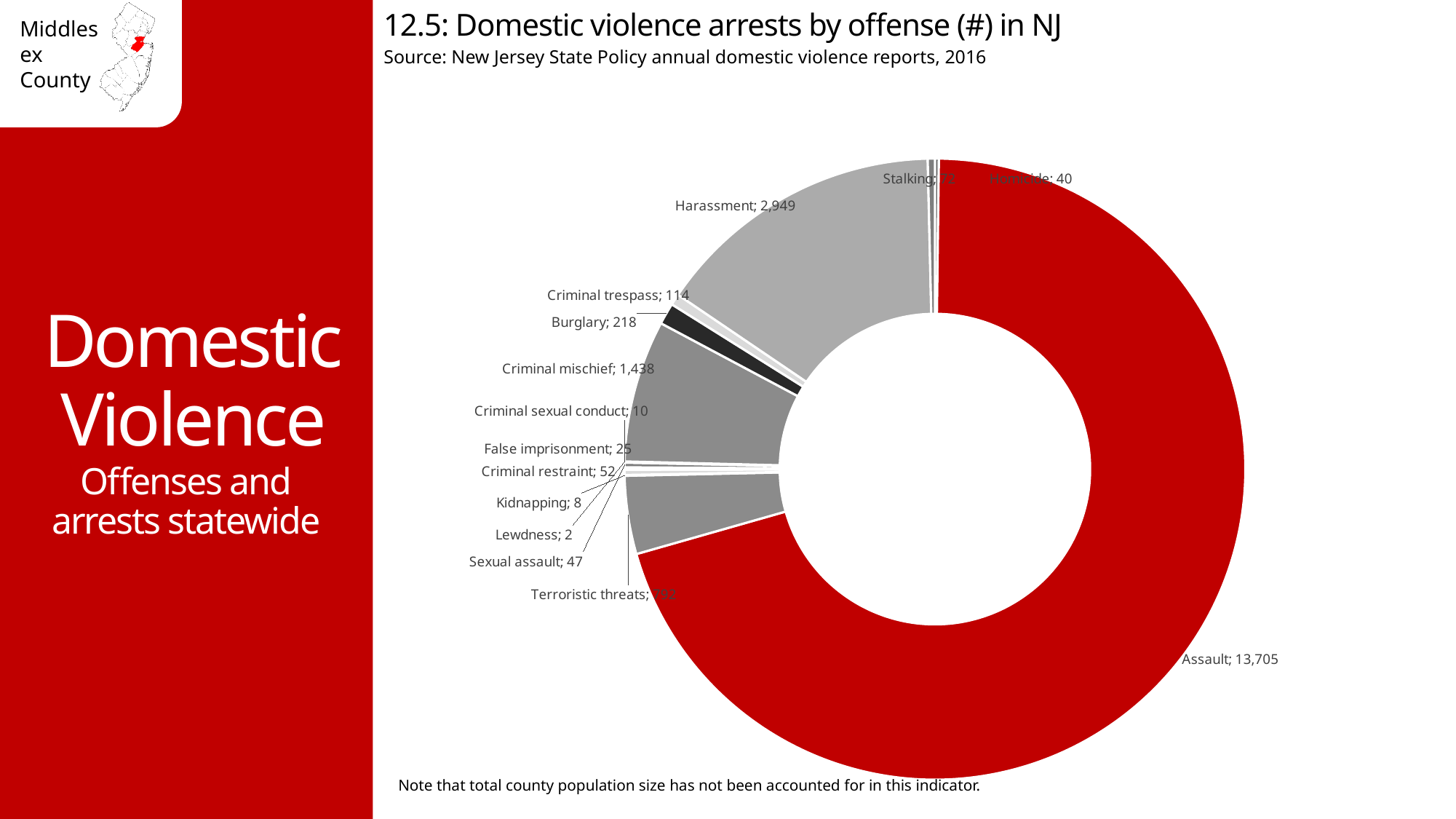
What is the value for Homicide? 40 What kind of chart is shown on the slide? Doughnut chart What is the value for Burglary? 218 Which is larger, the value for Harassment or the value for Criminal mischief? Harassment What is the title of the chart? 12.5: Domestic violence arrests by offense (#) in NJ What is the value for Criminal mischief? 1,438 How many offense categories are shown in the chart? 14 What is the difference between the values for Burglary and Criminal trespass? 104 How many domestic violence arrests for Assault are shown? 13,705 What is the value for Harassment? 2,949 Which offense has the lowest number of arrests? Lewdness Which offense has the highest number of arrests? Assault